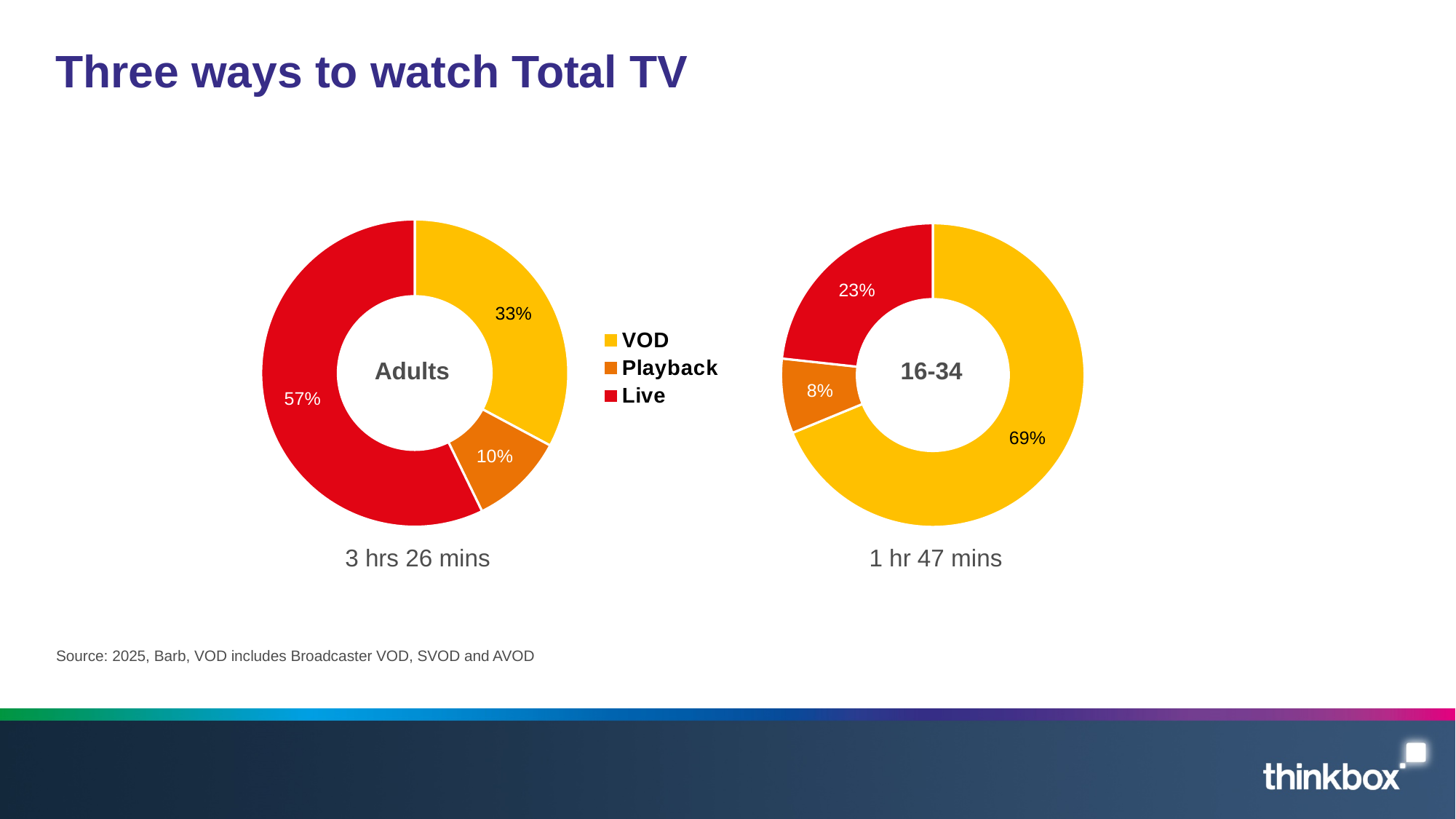
Is the VOD share larger in the Adults chart or the 16-34 chart? 16-34 In the Adults chart, what share of viewing is Live? 57% In the Adults chart, what is the difference between the Live share and the VOD share? 24 percentage points What total viewing time is shown beneath the Adults chart? 3 hrs 26 mins In the Adults chart, which category has the largest share? Live What kind of chart is used on this slide? Pie (doughnut) chart In the 16-34 chart, what share of viewing is Live? 23% How many categories does the legend list? 3 In the 16-34 chart, what is the difference between the VOD share and the Live share? 46 percentage points In the 16-34 chart, which category has the smallest share? Playback In the 16-34 chart, what share of viewing is VOD? 69% In the Adults chart, what share of viewing is Playback? 10%